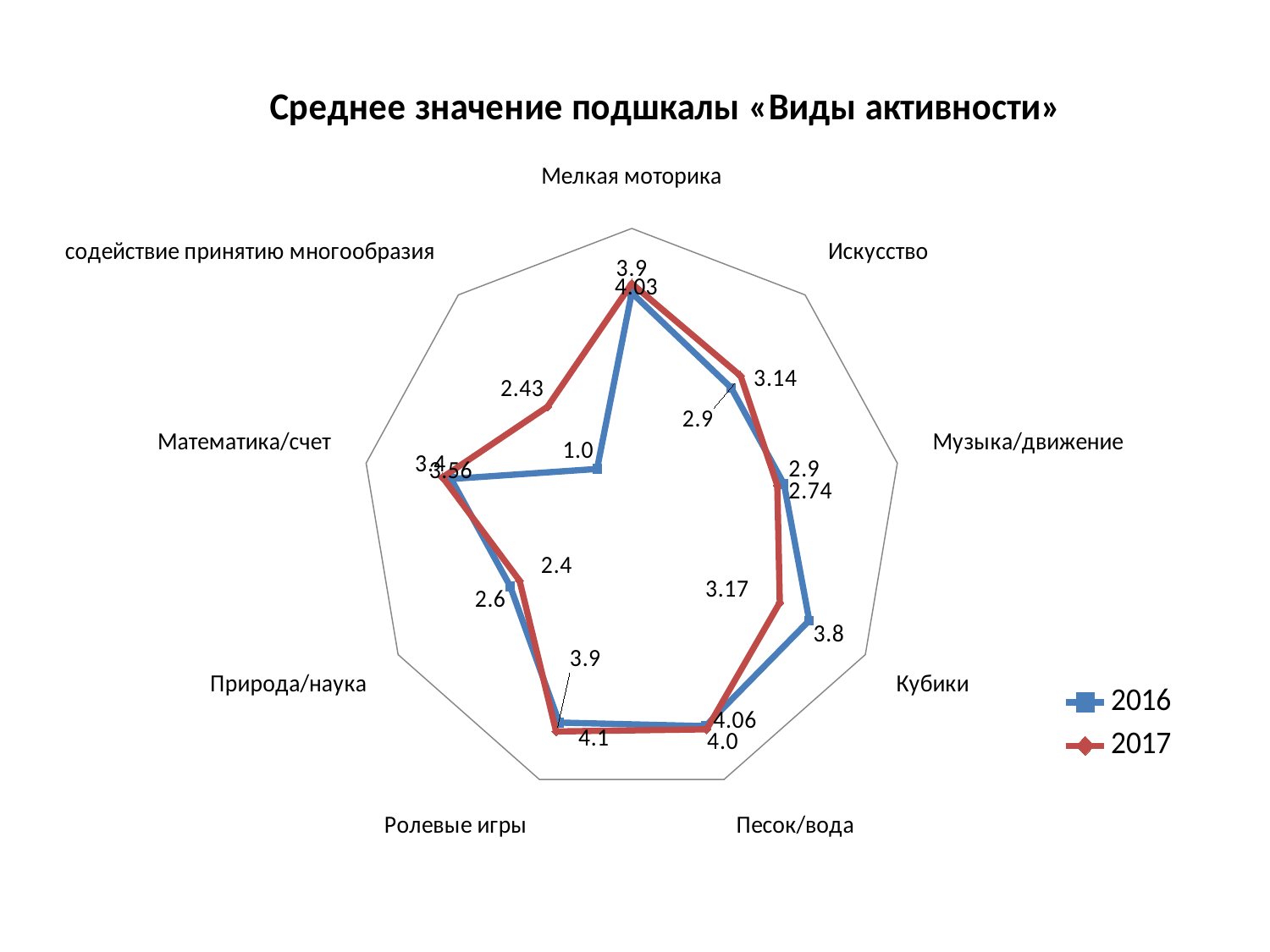
What is the 2017 value for Искусство? 3.14 What is the 2017 value for Кубики? 3.17 How many categories (axes) does the radar chart have? 9 How many series does the legend list? 2 For Искусство, which year has the larger value, 2016 or 2017? 2017 What is the 2017 value for содействие принятию многообразия? 2.43 Which category has the lowest value for the 2016 series? содействие принятию многообразия By how much did the value for содействие принятию многообразия increase from 2016 to 2017? 1.43 What is the 2016 value for содействие принятию многообразия? 1.0 What is the 2016 value for Кубики? 3.8 What type of chart is shown on the slide? Radar chart What is the difference between the 2016 and 2017 values for Кубики? 0.63